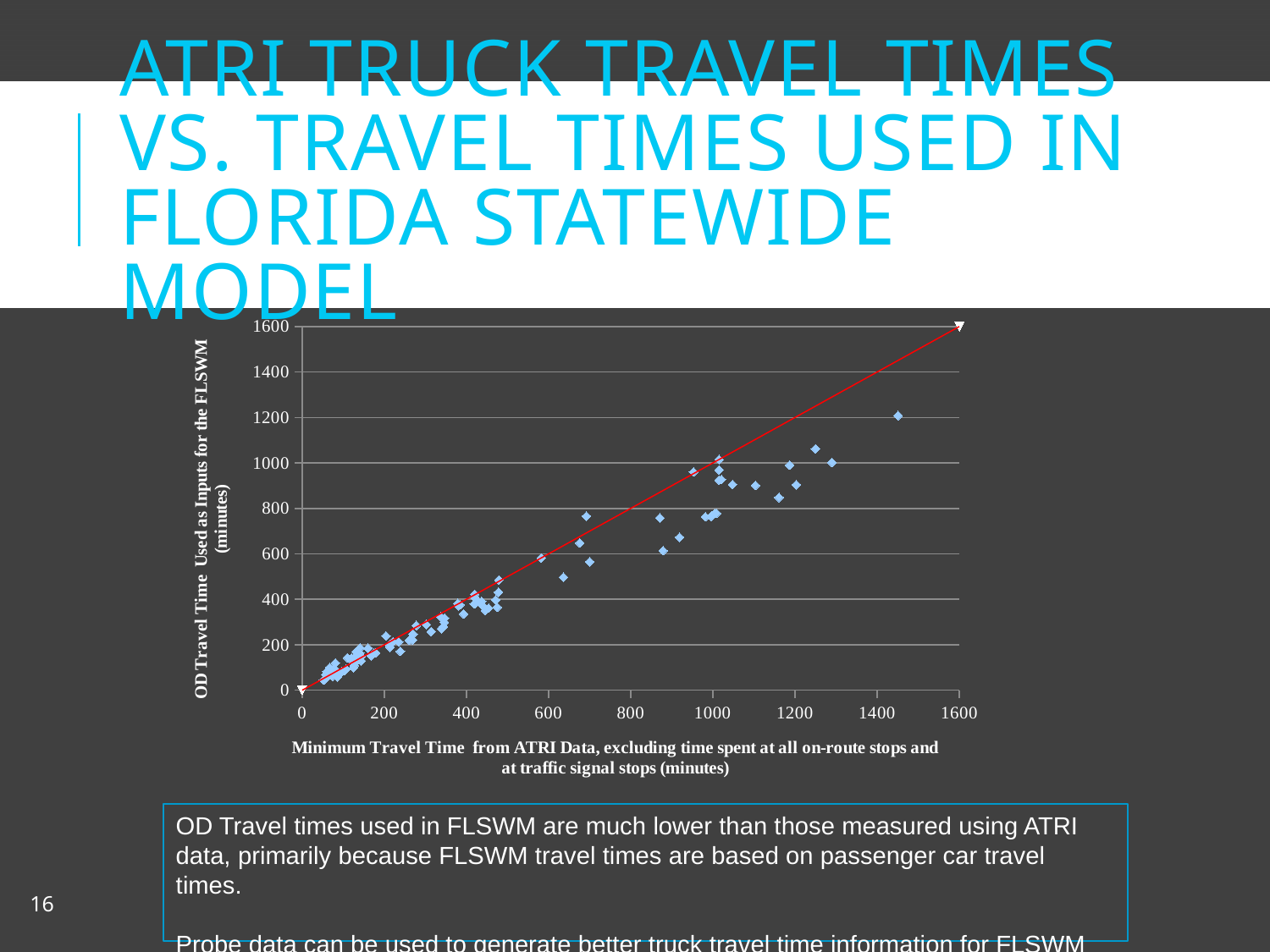
What is the highest tick value shown on the y axis of the chart? 1600 Is the highest plotted data point on the chart greater or less than 1000 on the y axis? greater What kind of chart is shown on the slide? scatter chart What is the title of the y axis of the chart? OD Travel Time Used as Inputs for the FLSWM (minutes) At what y value does the red reference line end at the right edge of the chart (x = 1600)? 1600 Is the highest plotted data point on the chart greater or less than 1400 on the y axis? less What is the title of the x axis of the chart? Minimum Travel Time from ATRI Data, excluding time spent at all on-route stops and at traffic signal stops (minutes) Do the plotted OD travel time values generally rise or fall as the minimum ATRI travel time increases along the x axis? rise Do most of the plotted points lie above or below the red reference line? below What is the highest tick value shown on the x axis of the chart? 1600